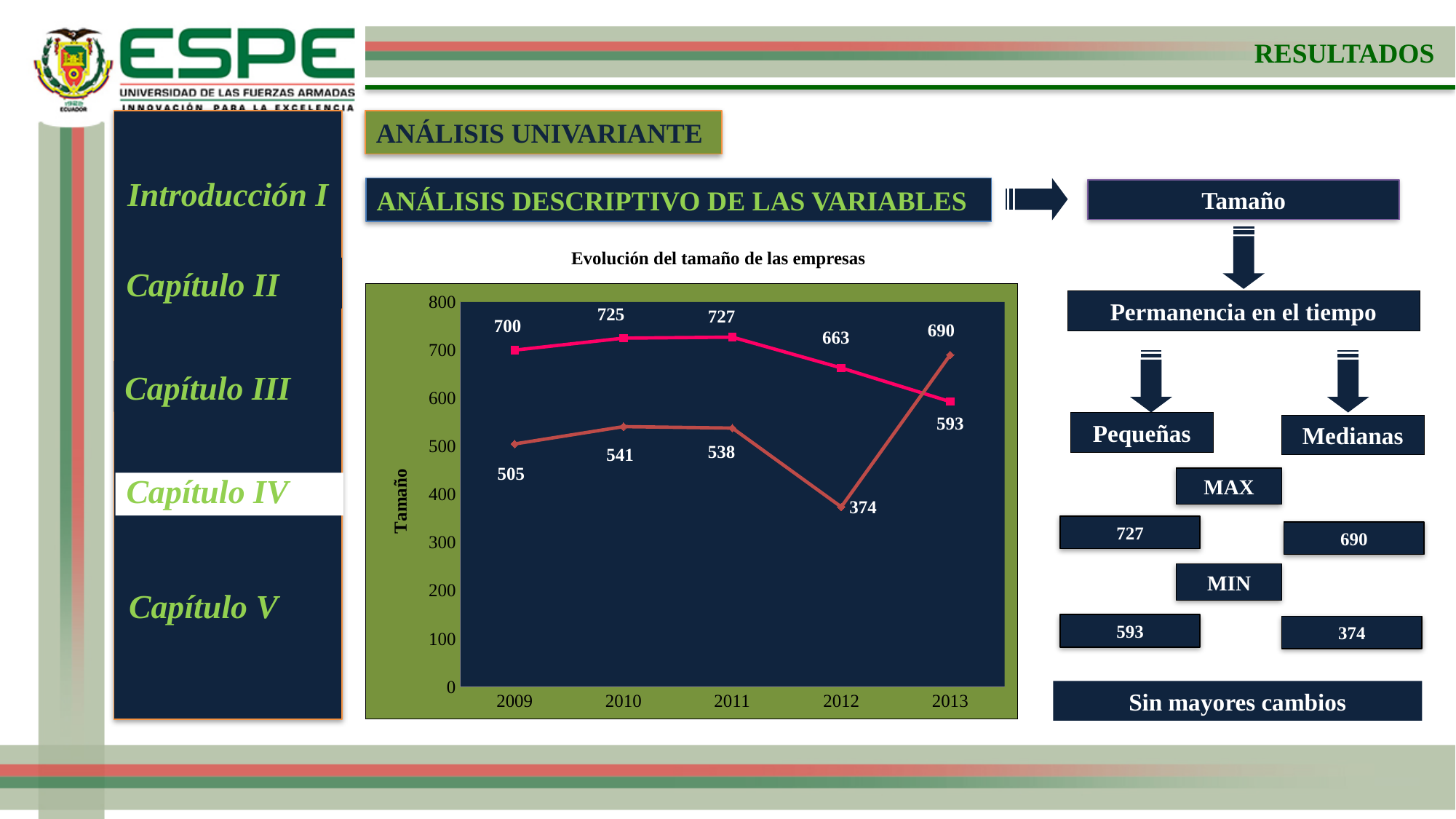
In which year does the pink line reach its highest value? 2011 What is the title of the chart? Evolución del tamaño de las empresas What kind of chart is shown on the slide? line chart In which year does the brown line reach its lowest value? 2012 What is the value of the pink line in 2012? 663 By how much did the pink line fall from 2009 to 2013? 107 How many years are plotted along the x axis of the chart? 5 Is the brown line's value in 2012 greater or less than 400? less What is the difference between the brown line's values in 2013 and 2012? 316 In 2013, which line has the higher value, the pink line or the brown line? the brown line What is the value of the brown line in 2013? 690 Does the pink line rise or fall from 2011 to 2013? fall